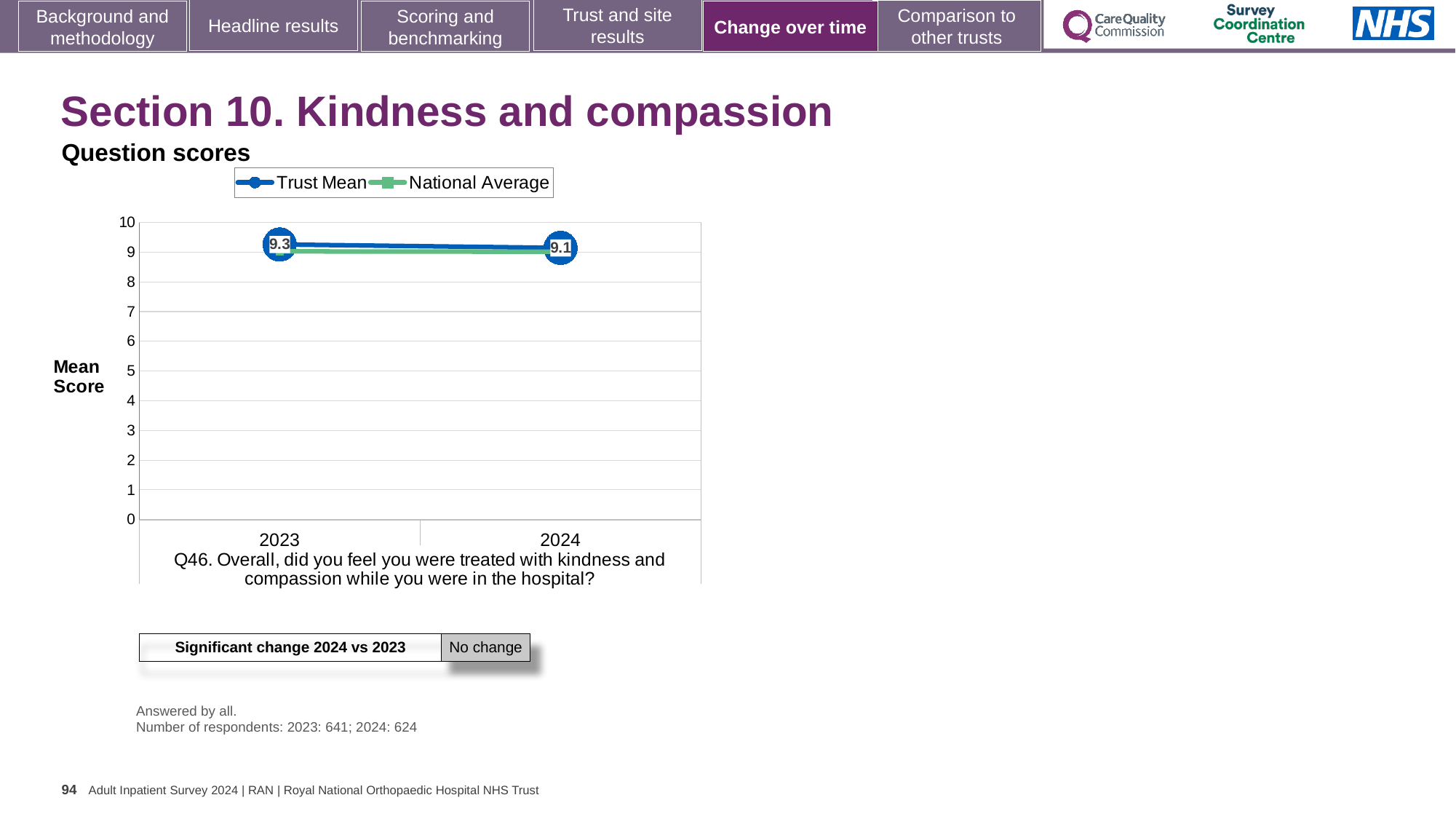
How many years are shown on the x axis of the chart? 2 Is the Trust Mean for 2023 larger or smaller than the Trust Mean for 2024? larger What is the Trust Mean score for 2023? 9.3 What is the label on the y axis of the chart? Mean Score In which year is the Trust Mean higher, 2023 or 2024? 2023 By how much did the Trust Mean change from 2023 to 2024? 0.2 What are the two series named in the chart legend? Trust Mean and National Average How many series does the chart legend list? 2 What is the Trust Mean score for 2024? 9.1 What kind of chart is shown on the slide? line chart Is the National Average for 2024 greater or less than 8? greater Does the Trust Mean rise or fall from 2023 to 2024? fall